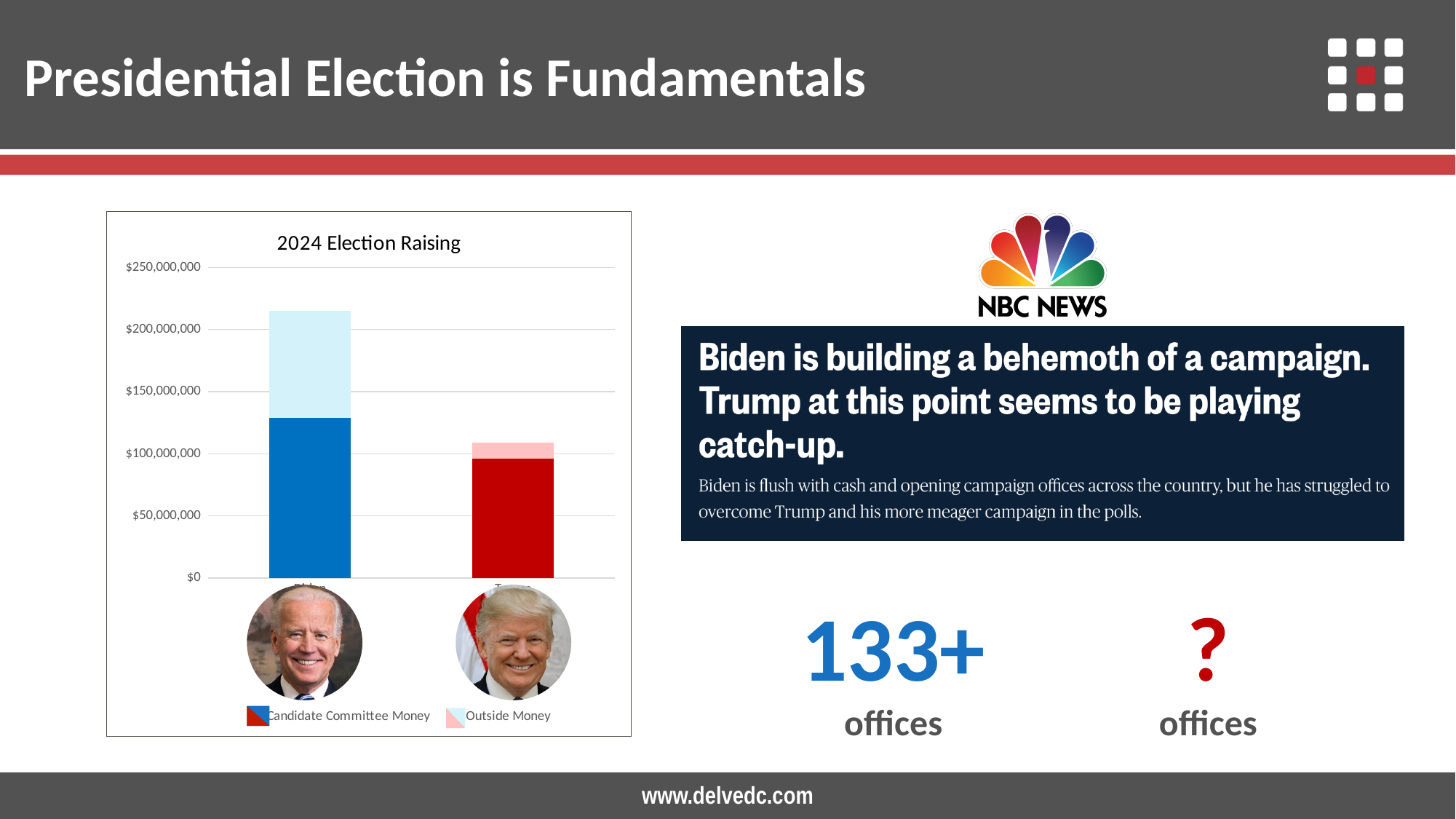
In the 2024 Election Raising chart, which candidate has more Outside Money, Biden or Trump? Biden Which candidate has the shorter total stacked bar in the 2024 Election Raising chart? Trump What is the title of the chart on the slide? 2024 Election Raising How many series does the legend of the 2024 Election Raising chart list? 2 Which candidate has the taller total stacked bar in the 2024 Election Raising chart? Biden Is Biden's Candidate Committee Money in the 2024 Election Raising chart greater or less than $100,000,000? greater What are the two series named in the legend of the 2024 Election Raising chart? Candidate Committee Money and Outside Money Is Biden's total bar in the 2024 Election Raising chart greater or less than $200,000,000? greater How many candidates (categories) are shown in the 2024 Election Raising chart? 2 Is Trump's total bar in the 2024 Election Raising chart greater or less than $150,000,000? less What kind of chart is the 2024 Election Raising chart? bar chart